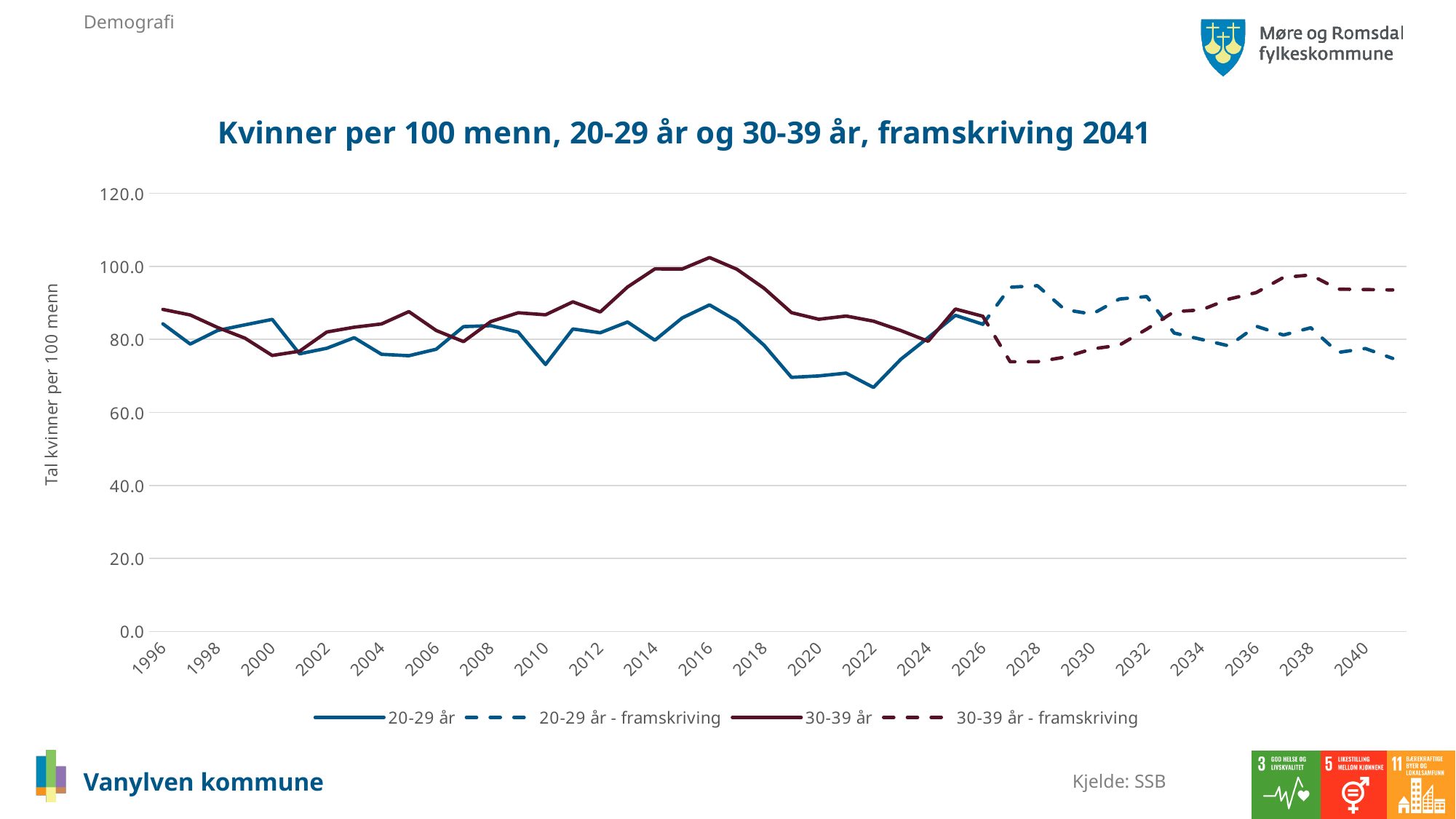
Does the 30-39 år series rise or fall between 2010 and 2016? rise What is the title of the chart? Kvinner per 100 menn, 20-29 år og 30-39 år, framskriving 2041 In 2028, which series has the higher value, 20-29 år - framskriving or 30-39 år - framskriving? 20-29 år - framskriving How many series does the legend list? 4 Is the value for 30-39 år - framskriving in 2038 greater or less than 80? greater Does the 20-29 år series rise or fall between 2016 and 2022? fall Is the value for 20-29 år in 2022 greater or less than 80? less What kind of chart is shown on the slide? line chart What is the label on the vertical axis? Tal kvinner per 100 menn In 2016, which series has the higher value, 20-29 år or 30-39 år? 30-39 år Is the value for 30-39 år in 2016 greater or less than 100? greater